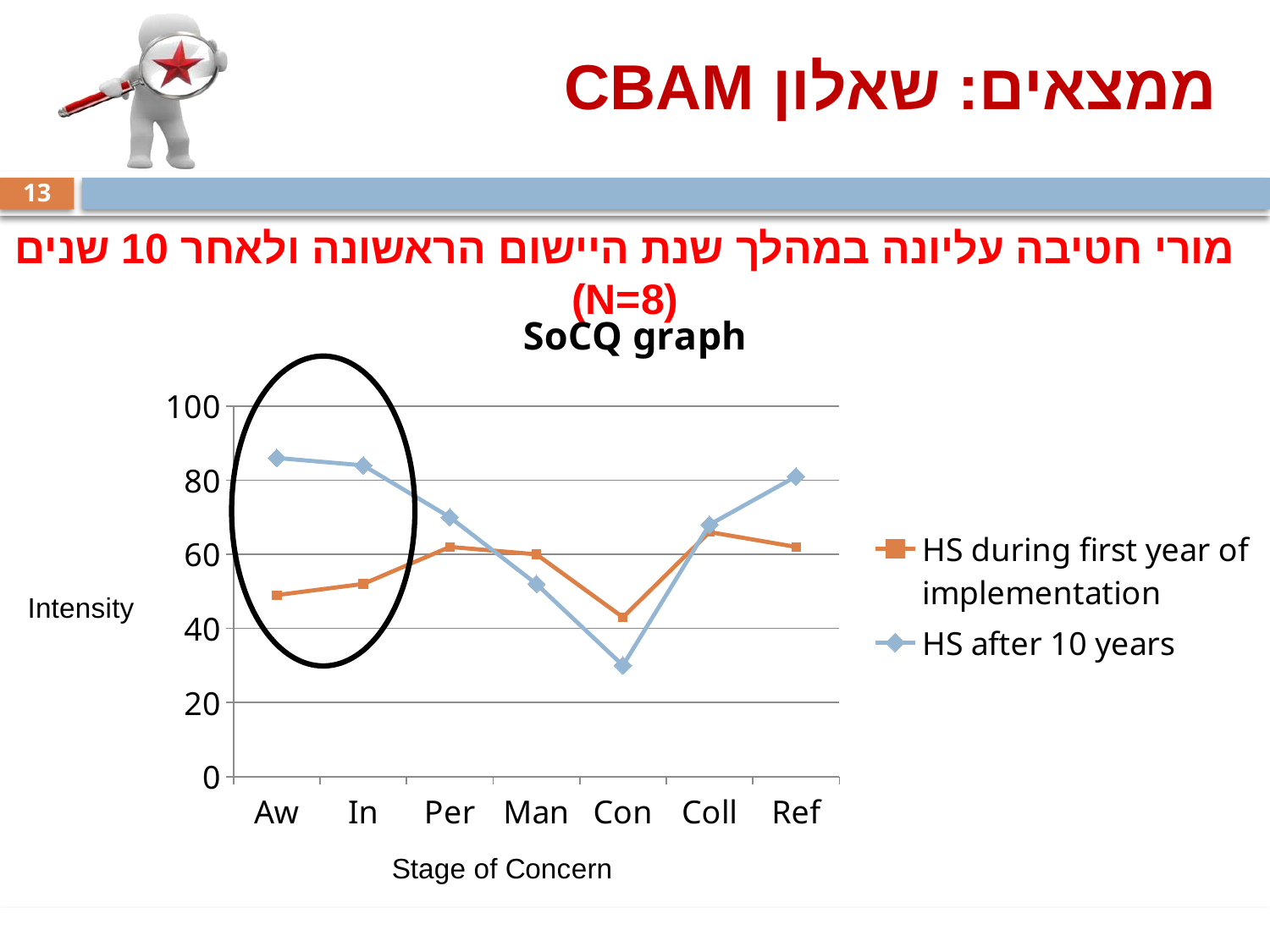
How many series does the legend of the SoCQ graph list? 2 At the Man stage, which series has the higher value? HS during first year of implementation Which stage of concern has the lowest value for the HS during first year of implementation series? Con What is the label of the y axis of the SoCQ graph? Intensity Is the value for HS after 10 years at Aw greater or less than 80? greater Does the HS after 10 years series rise or fall from Aw to Con? fall At the Aw stage, which series has the higher value? HS after 10 years What kind of chart is the SoCQ graph? line chart Is the value for HS after 10 years at Con greater or less than 40? less Which stage of concern has the lowest value for the HS after 10 years series? Con Is the value for HS during first year of implementation at Aw greater or less than 60? less How many stages of concern are shown on the x axis of the SoCQ graph? 7